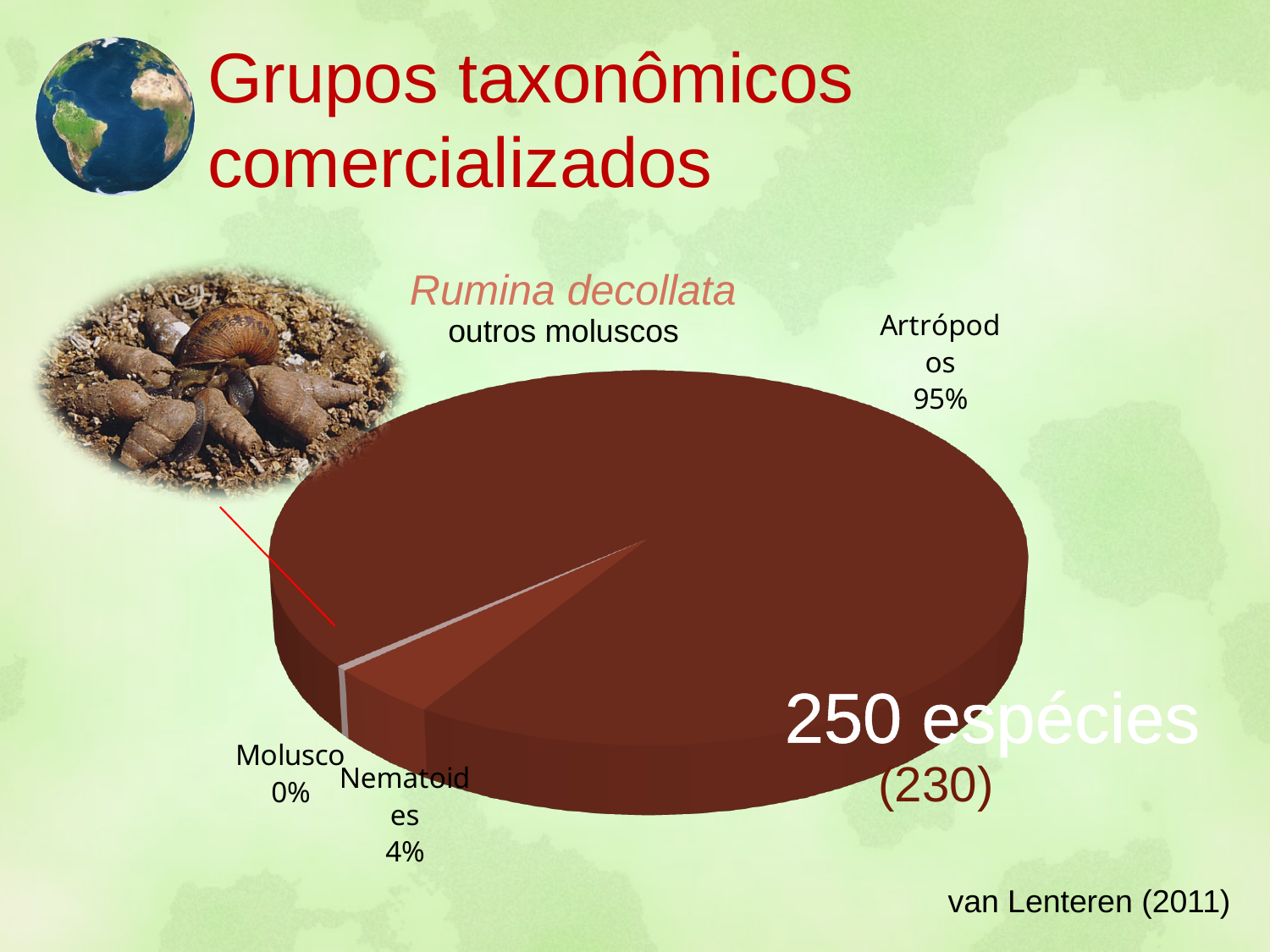
What kind of chart is shown on the slide? pie chart Which group has the smallest slice of the pie chart? Molusco How many slices are labelled in the pie chart? 3 What is the difference in percentage points between Artrópodos and Nematoides? 91 What percentage of the pie chart is Artrópodos? 95% Which group has the largest slice of the pie chart? Artrópodos Which slice is larger, Nematoides or Molusco? Nematoides What percentage of the pie chart is Nematoides? 4% What percentage of the pie chart is Molusco? 0% What is the title of the slide containing the pie chart? Grupos taxonômicos comercializados What source is cited for the pie chart data? van Lenteren (2011) Is the share for Artrópodos greater or less than 50%? greater